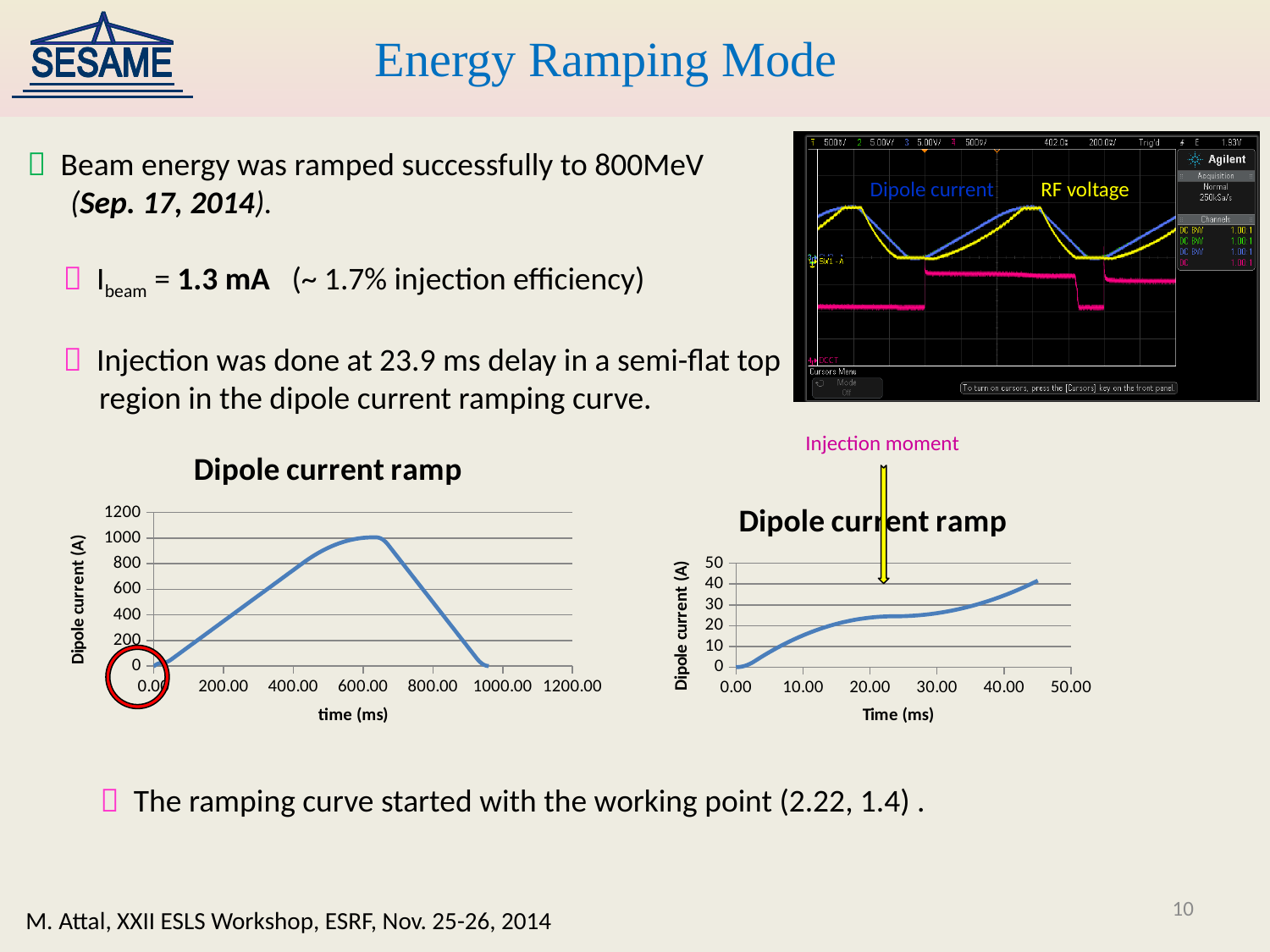
In the lower-left 'Dipole current ramp' chart, does the dipole current rise or fall between 700.00 and 900.00 ms? fall In the lower-left 'Dipole current ramp' chart, does the dipole current rise or fall between 0.00 and 600.00 ms? rise What is the highest tick value shown on the y axis of the lower-right 'Dipole current ramp' chart? 50 In the lower-right 'Dipole current ramp' chart, is the value at 45.00 ms greater or less than 30? greater What is the title of the chart on the lower left of the slide? Dipole current ramp In the lower-right 'Dipole current ramp' chart, is the value at 10.00 ms greater or less than 20? less What is the x-axis label of the lower-right 'Dipole current ramp' chart? Time (ms) What kind of chart is the left 'Dipole current ramp' chart? line chart In the lower-left 'Dipole current ramp' chart, is the value at 900.00 ms greater or less than 400? less In the lower-right 'Dipole current ramp' chart, does the dipole current rise or fall overall from 0.00 to 50.00 ms? rise What is the highest tick value shown on the x axis of the lower-left 'Dipole current ramp' chart? 1200.00